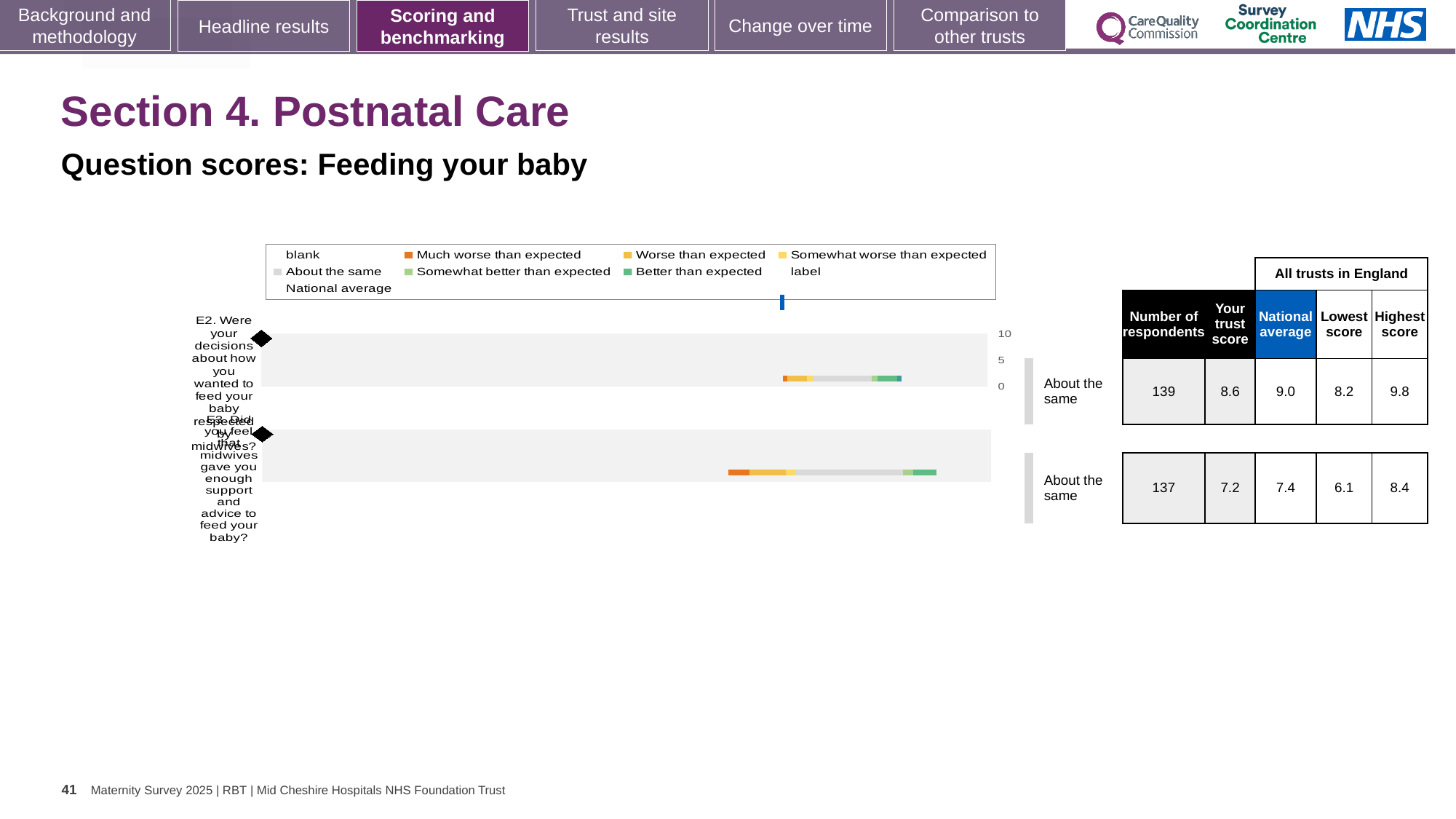
What is the trust score for question E3 (midwives gave you enough support and advice to feed your baby)? 7.2 What kind of chart is used to show the question scores for Feeding your baby? Bar chart What benchmark category is shown for question E3? About the same What is the lowest score among all trusts in England for question E3? 6.1 What is the highest score among all trusts in England for question E2? 9.8 How many questions (categories) are plotted in the Feeding your baby chart? 2 What is the national average for question E2? 9.0 How many respondents answered question E3? 137 What is the difference between the national average and the trust score for question E2? 0.4 What is the trust score for question E2 (decisions about how you wanted to feed your baby respected by midwives)? 8.6 What is the difference between the highest and lowest scores for question E3? 2.3 Which question has the higher trust score, E2 or E3? E2